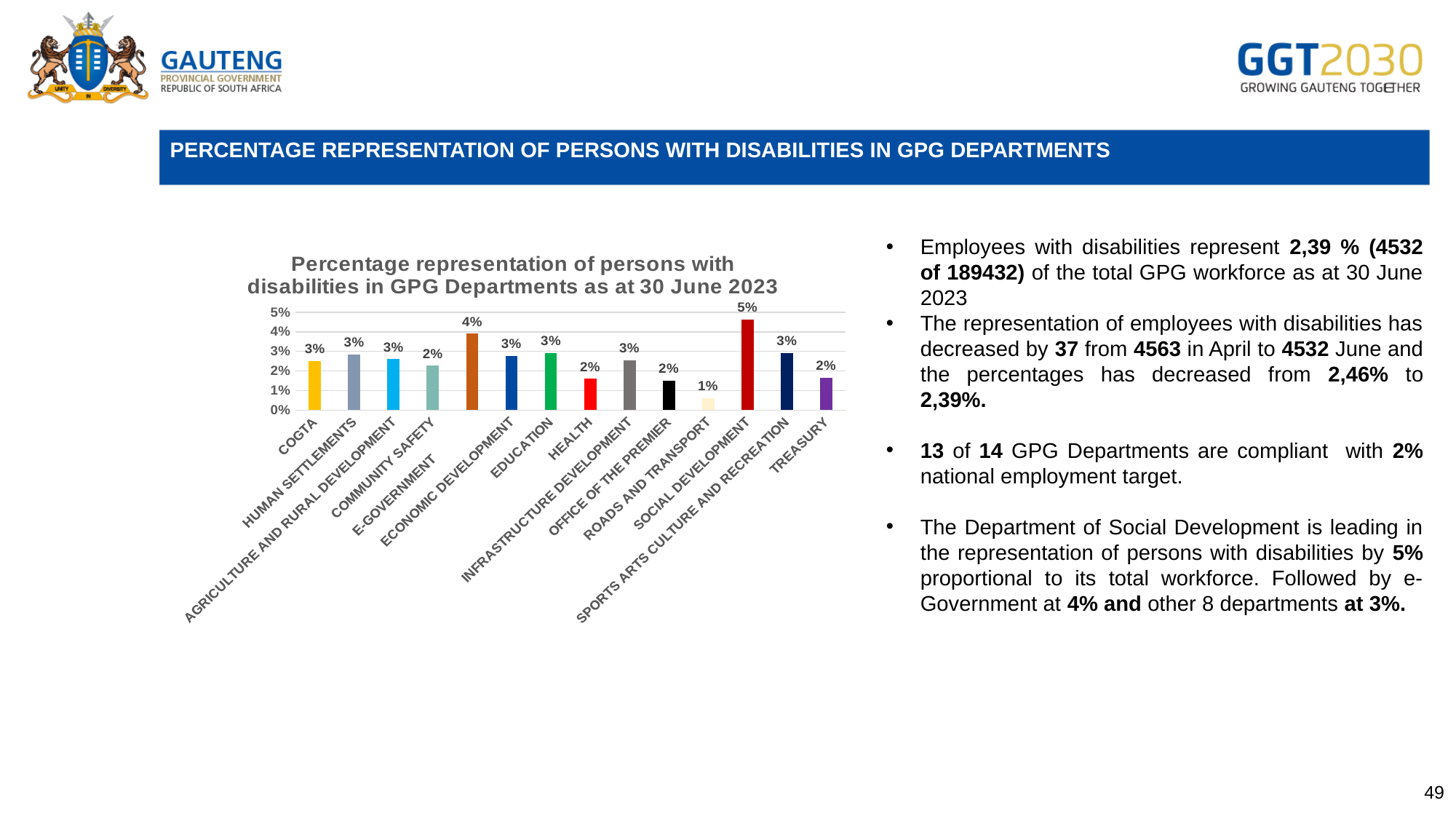
Which has a larger value, E-GOVERNMENT or HEALTH? E-GOVERNMENT How many departments are shown on the x axis of the chart? 14 What is the value shown for SOCIAL DEVELOPMENT? 5% Which department has the lowest percentage representation of persons with disabilities? ROADS AND TRANSPORT What kind of chart is shown on the slide? bar chart What is the title of the chart? Percentage representation of persons with disabilities in GPG Departments as at 30 June 2023 Which department has the highest percentage representation of persons with disabilities? SOCIAL DEVELOPMENT What is the value shown for ROADS AND TRANSPORT? 1% What is the value shown for HEALTH? 2% What is the difference between the values for SOCIAL DEVELOPMENT and ROADS AND TRANSPORT? 4 percentage points Is the value for SOCIAL DEVELOPMENT greater or less than 4%? greater What is the value shown for E-GOVERNMENT? 4%